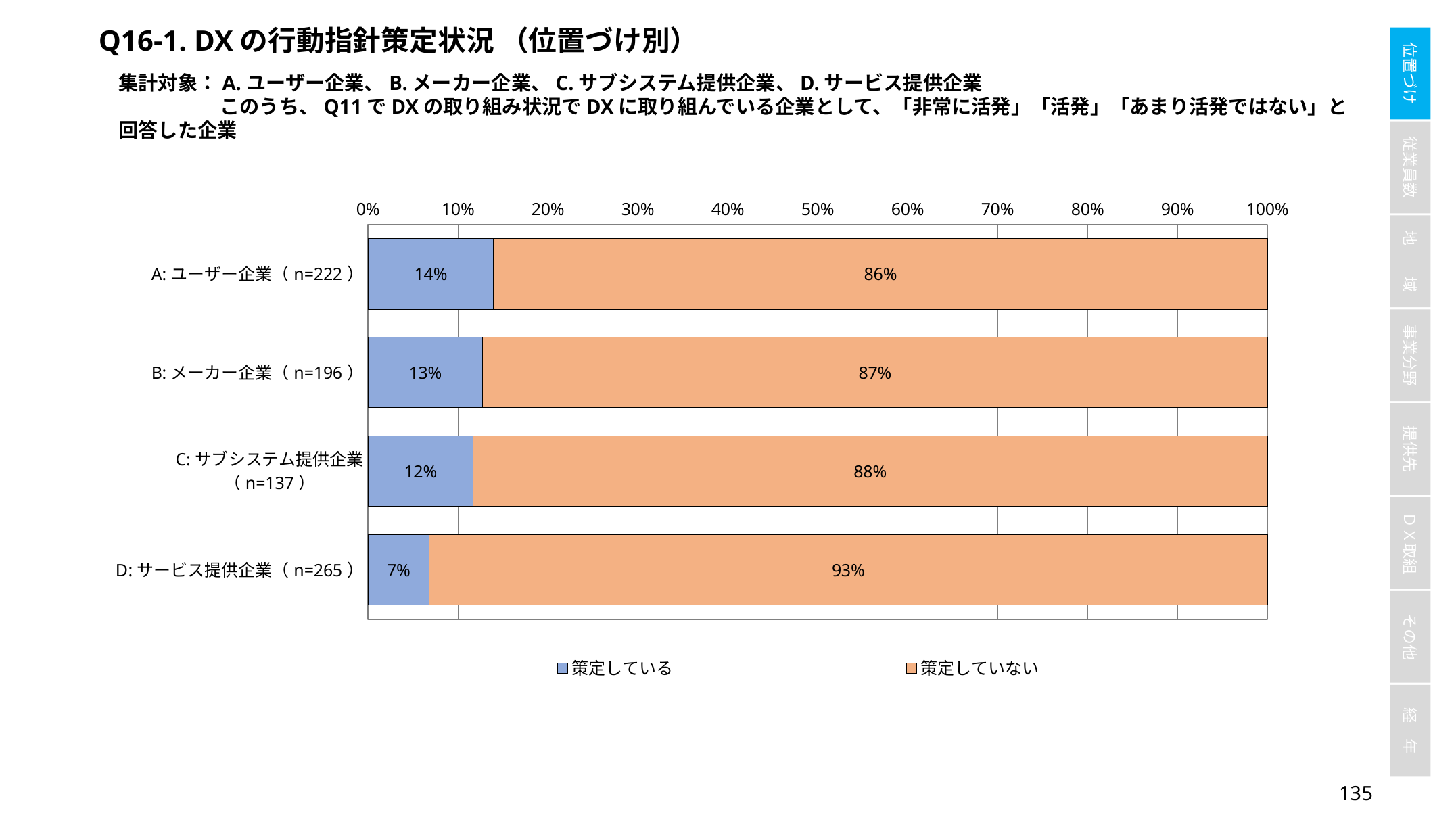
How many categories are shown on the chart? 4 What is the total of the two segments for B: メーカー企業 (n=196)? 100% What kind of chart is shown on the slide? Stacked bar chart Which category has the lowest share of 策定している? D: サービス提供企業 (n=265) How many series does the legend list? 2 What percentage of B: メーカー企業 (n=196) answered 策定していない? 87% Which is larger: the 策定していない share for B: メーカー企業 or for C: サブシステム提供企業? C: サブシステム提供企業 What percentage of C: サブシステム提供企業 (n=137) answered 策定している? 12% What is the difference in percentage points between the 策定している share for A: ユーザー企業 and D: サービス提供企業? 7 percentage points What percentage of D: サービス提供企業 (n=265) answered 策定していない? 93% What percentage of A: ユーザー企業 (n=222) answered 策定している? 14% Which category has the highest share of 策定している? A: ユーザー企業 (n=222)